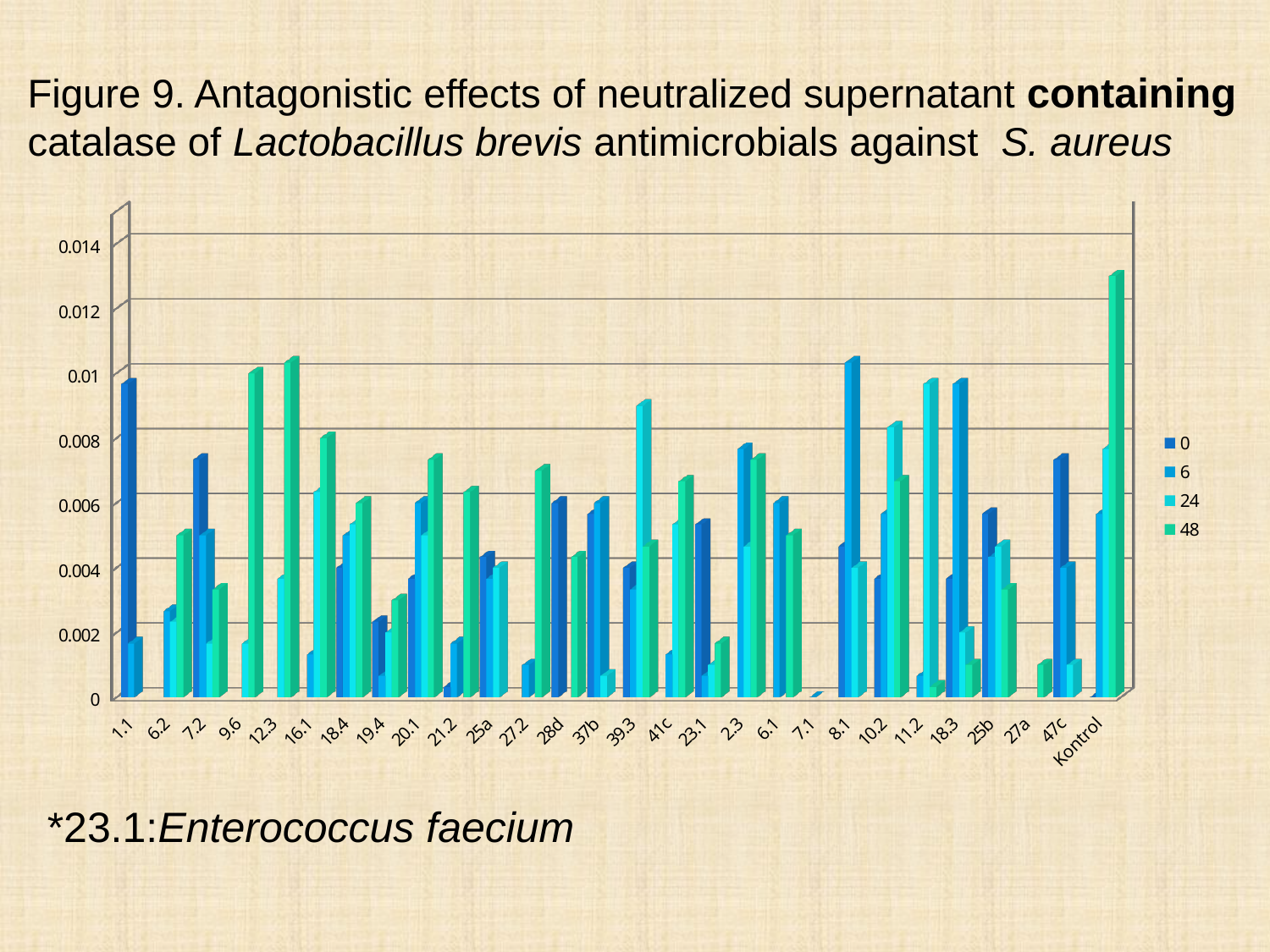
Is the value of series 0 for 7.1 greater or less than 0.002? less Which is larger: the value of series 48 for Kontrol or the value of series 0 for 1.1? series 48 for Kontrol How many series does the legend list? 4 What kind of chart is shown on the slide? bar chart What are the series names listed in the legend? 0, 6, 24, 48 Is the value of series 48 for Kontrol greater or less than 0.012? greater Is the value of series 48 for 27a greater or less than 0.002? less Which category has the tallest bar in the chart? Kontrol For the Kontrol category, which series has the highest value? 48 How many categories are shown along the x axis? 28 What is the label of the last category on the x axis? Kontrol